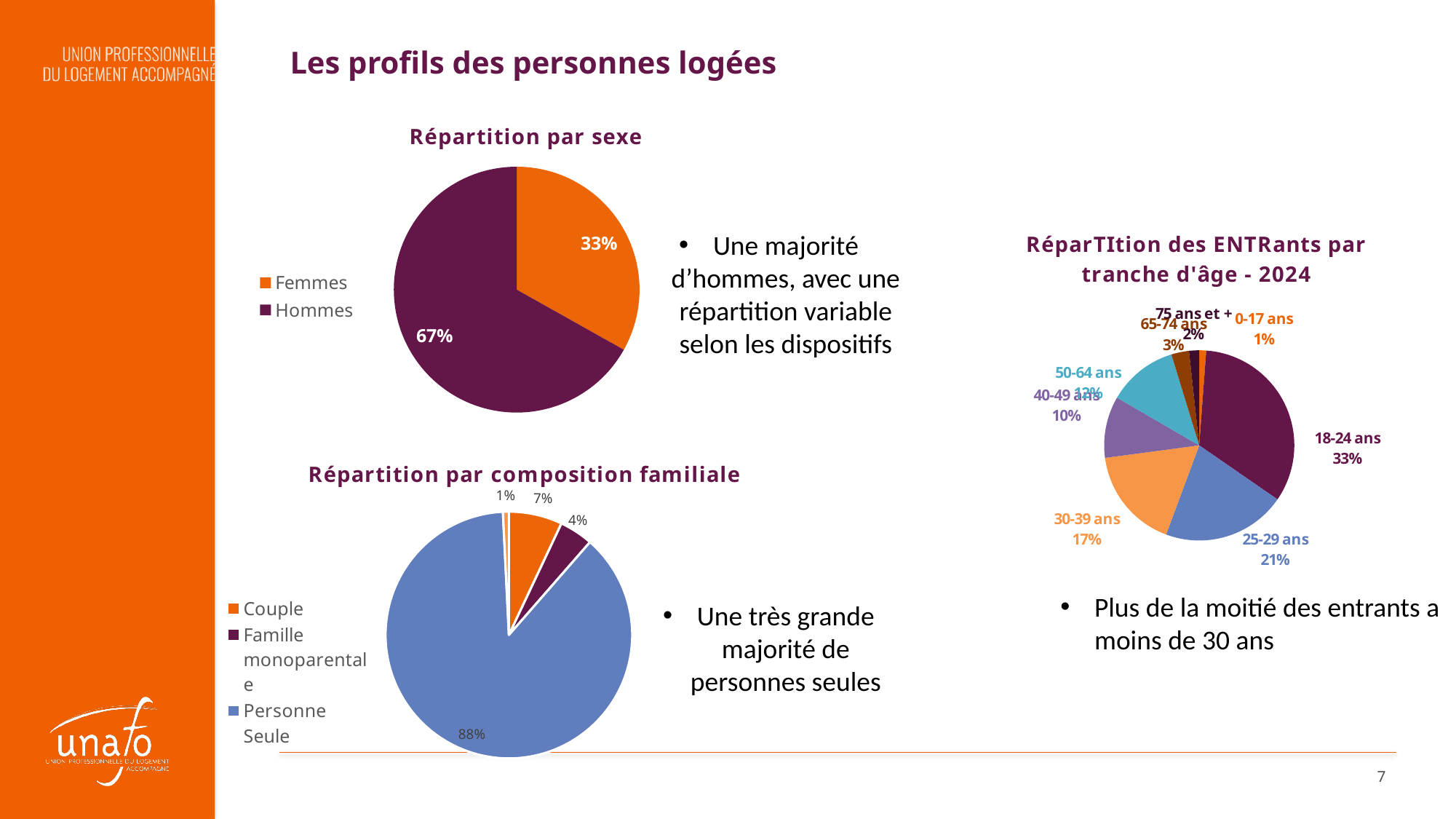
How many age groups are shown in the 'RéparTItion des ENTRants par tranche d'âge - 2024' chart? 8 What type of chart is 'Répartition par sexe'? Pie chart In the 'Répartition par sexe' chart, what percentage is shown for Hommes? 67% In the 'Répartition par composition familiale' chart, what percentage is shown for Personne Seule? 88% In the 'Répartition par sexe' chart, what percentage is shown for Femmes? 33% In the 'Répartition par sexe' chart, what is the difference in percentage points between Hommes and Femmes? 34 In the 'RéparTItion des ENTRants par tranche d'âge - 2024' chart, which age group has the largest share? 18-24 ans In the 'RéparTItion des ENTRants par tranche d'âge - 2024' chart, which age group has the smallest share? 0-17 ans In the 'Répartition par composition familiale' chart, what percentage is shown for Couple? 7% In the 'Répartition par composition familiale' chart, which is larger, Couple or Famille monoparentale? Couple In the 'RéparTItion des ENTRants par tranche d'âge - 2024' chart, what is the difference in percentage points between 30-39 ans and 40-49 ans? 7 In the 'RéparTItion des ENTRants par tranche d'âge - 2024' chart, what percentage is shown for 25-29 ans? 21%